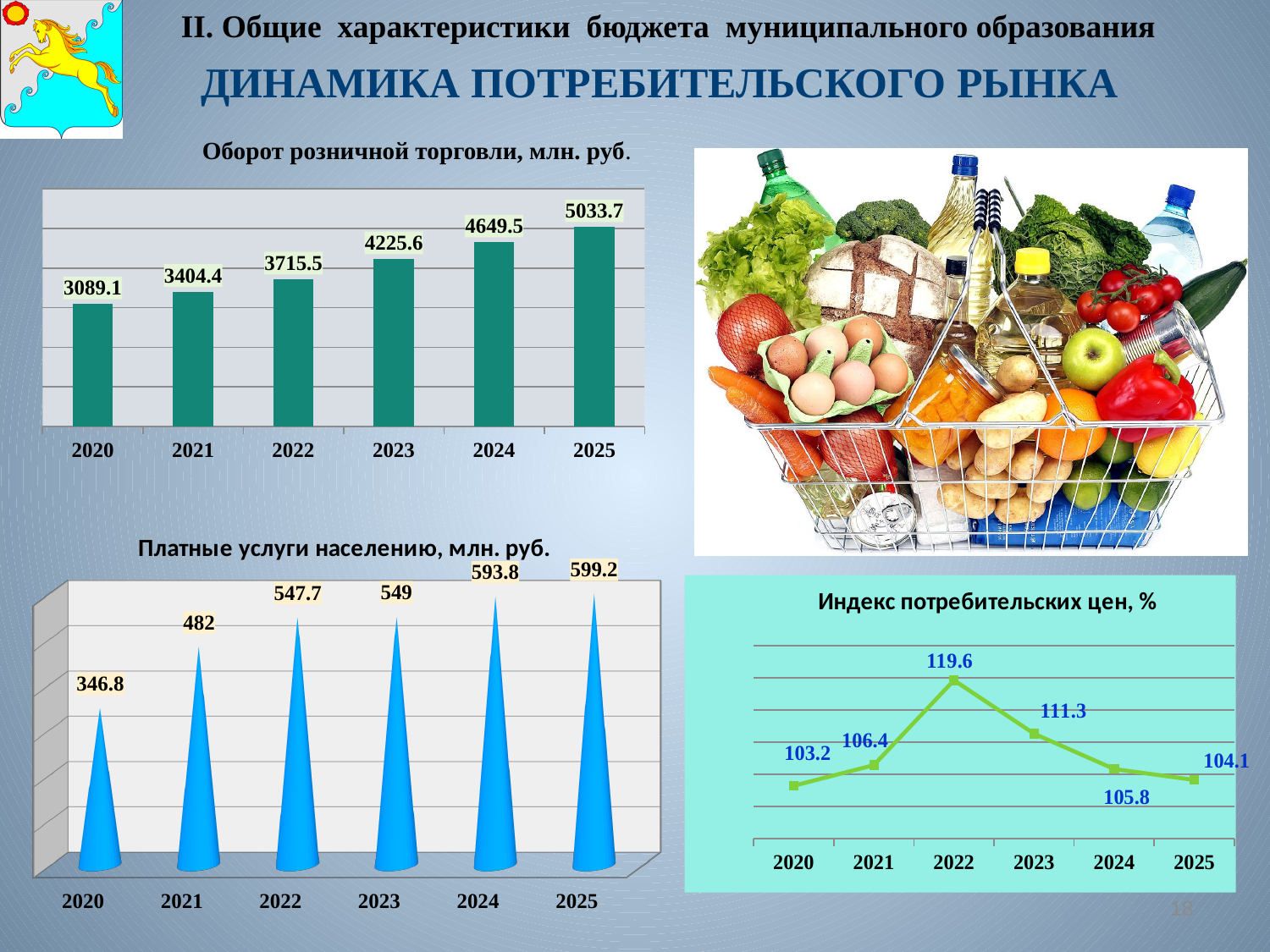
In the chart 'Платные услуги населению, млн. руб.', how many years are shown on the x axis? 6 In the chart 'Оборот розничной торговли, млн. руб.', what is the value for 2023? 4225.6 In the chart 'Платные услуги населению, млн. руб.', what is the value for 2021? 482 In the chart 'Индекс потребительских цен, %', what is the value for 2022? 119.6 In the chart 'Индекс потребительских цен, %', which year has the highest value? 2022 In the chart 'Оборот розничной торговли, млн. руб.', what is the difference between the 2025 and 2020 values? 1944.6 In the chart 'Платные услуги населению, млн. руб.', what is the difference between the 2024 and 2023 values? 44.8 What kind of chart is 'Оборот розничной торговли, млн. руб.'? bar chart In the chart 'Оборот розничной торговли, млн. руб.', do the values rise or fall from 2020 to 2025? rise In the chart 'Оборот розничной торговли, млн. руб.', which year has the highest value? 2025 In the chart 'Платные услуги населению, млн. руб.', which year has the lowest value? 2020 In the chart 'Индекс потребительских цен, %', which is larger, the value for 2023 or the value for 2024? 2023